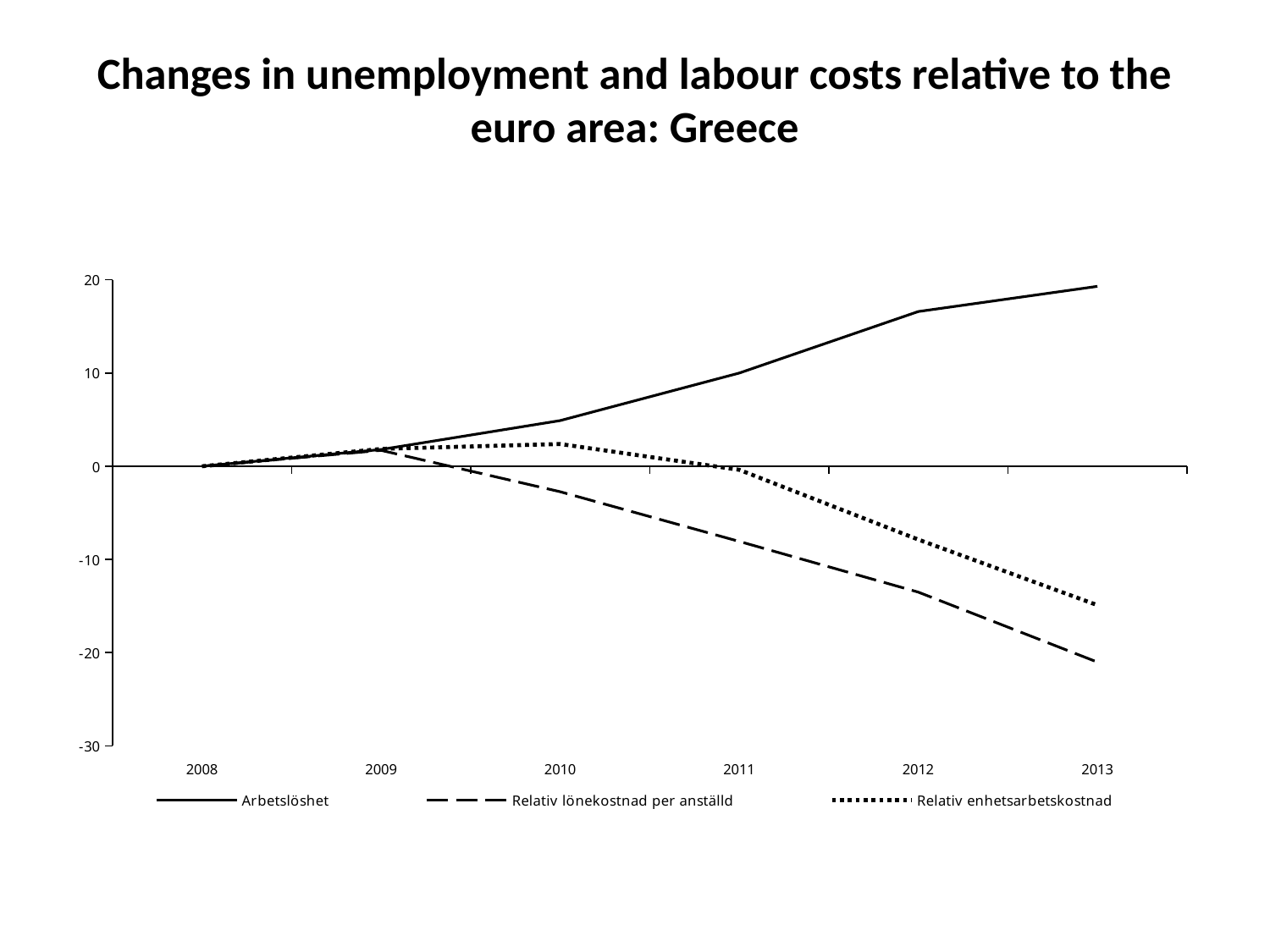
Does the Arbetslöshet series rise or fall from 2008 to 2013? rise Is the value for Arbetslöshet in 2013 greater or less than 10? greater What kind of chart is shown on the slide? line chart Is the value for Relativ enhetsarbetskostnad in 2013 greater or less than -10? less What is the title of the chart? Changes in unemployment and labour costs relative to the euro area: Greece How many series does the legend list? 3 How many years are shown on the x axis? 6 Does the Relativ lönekostnad per anställd series rise or fall from 2009 to 2013? fall Which series is drawn with a dotted line? Relativ enhetsarbetskostnad In 2013, which series has the higher value: Relativ enhetsarbetskostnad or Relativ lönekostnad per anställd? Relativ enhetsarbetskostnad Is the value for Relativ lönekostnad per anställd in 2013 greater or less than -10? less What is the value of Arbetslöshet in 2008? 0